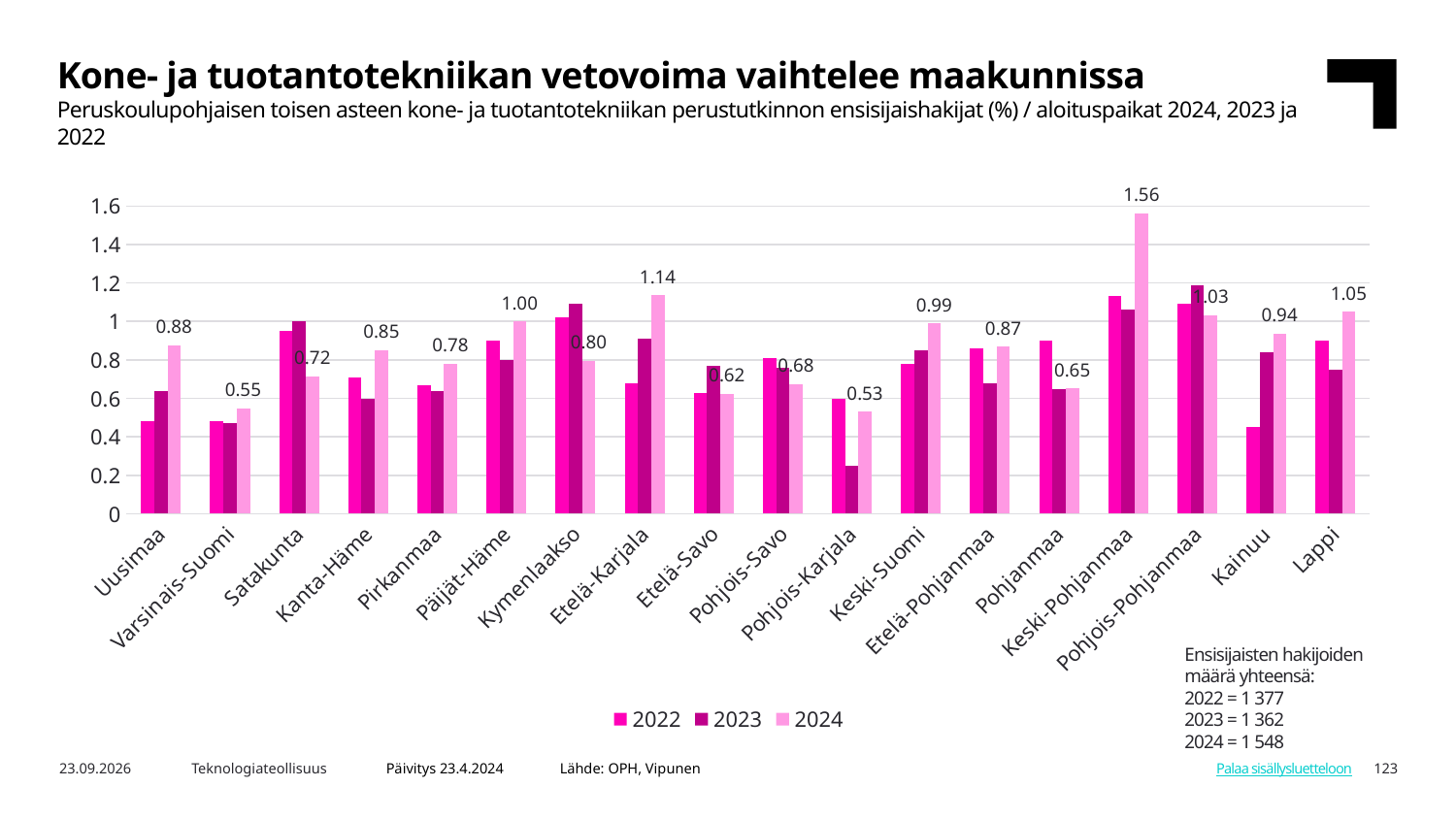
Is the 2023 value for Pohjois-Karjala greater or less than 0.4? less Is the 2022 value for Keski-Pohjanmaa greater or less than 1? greater Which region has the lowest 2024 value? Pohjois-Karjala How many regions are shown on the x axis? 18 Which region has the highest 2024 value? Keski-Pohjanmaa What is the 2024 value for Keski-Pohjanmaa? 1.56 What kind of chart is shown on the slide? Bar chart What is the difference between the 2024 values for Keski-Pohjanmaa and Lappi? 0.51 What is the 2024 value for Pohjois-Karjala? 0.53 Which has the larger 2024 value, Uusimaa or Varsinais-Suomi? Uusimaa How many series does the legend list? 3 What is the 2024 value for Päijät-Häme? 1.00